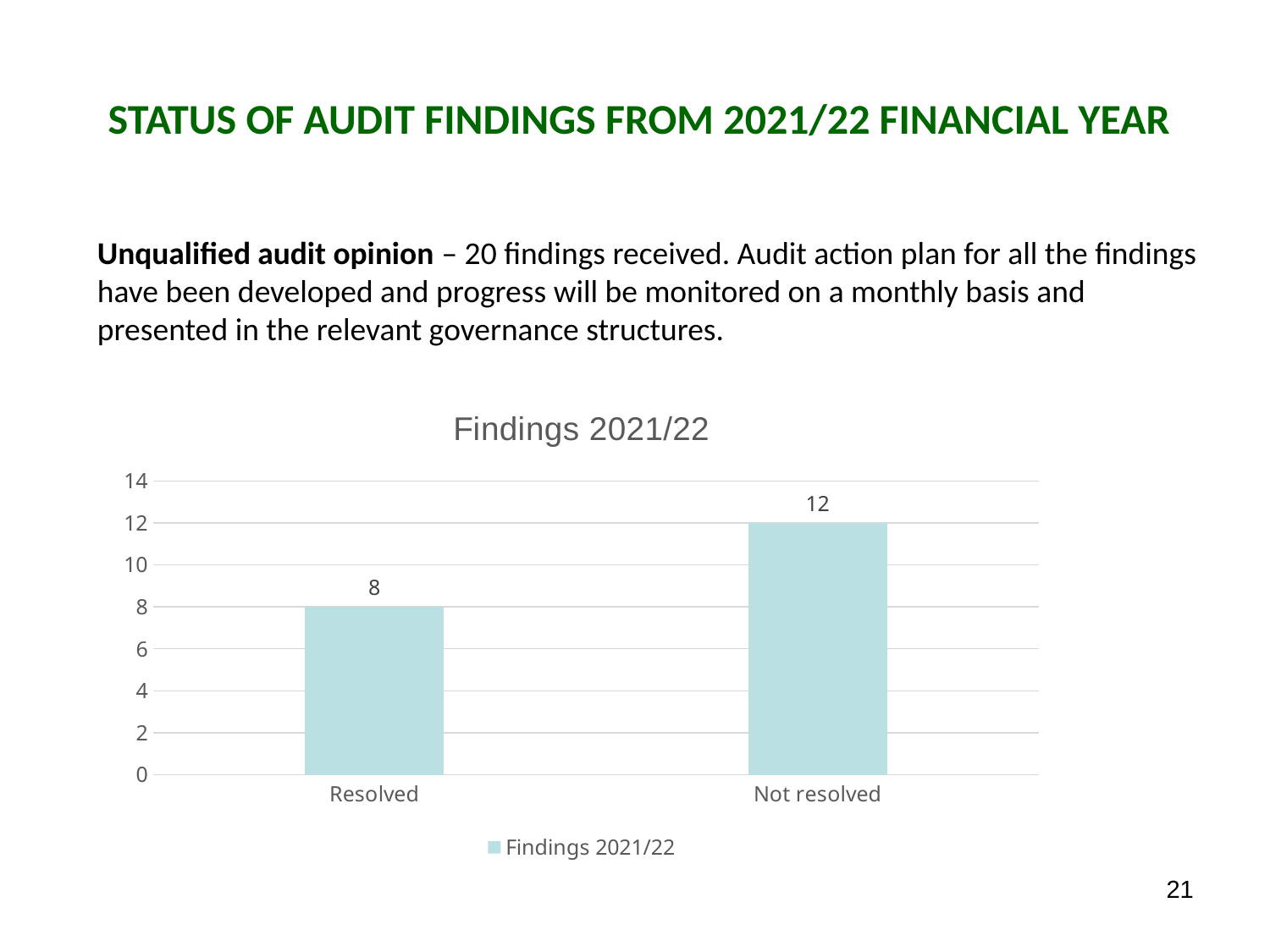
What is the title of the chart on the slide? Findings 2021/22 What is the value for Not resolved in the Findings 2021/22 chart? 12 How many categories are shown in the Findings 2021/22 chart? 2 Which category has the highest value in the Findings 2021/22 chart? Not resolved How many series does the legend of the Findings 2021/22 chart list? 1 What kind of chart is the Findings 2021/22 chart? Bar chart What is the difference between the Not resolved and Resolved values in the Findings 2021/22 chart? 4 What is the value for Resolved in the Findings 2021/22 chart? 8 Which is larger in the Findings 2021/22 chart, Resolved or Not resolved? Not resolved Which category has the lowest value in the Findings 2021/22 chart? Resolved Is the value for Not resolved greater or less than 10? greater Is the value for Resolved greater or less than 10? less